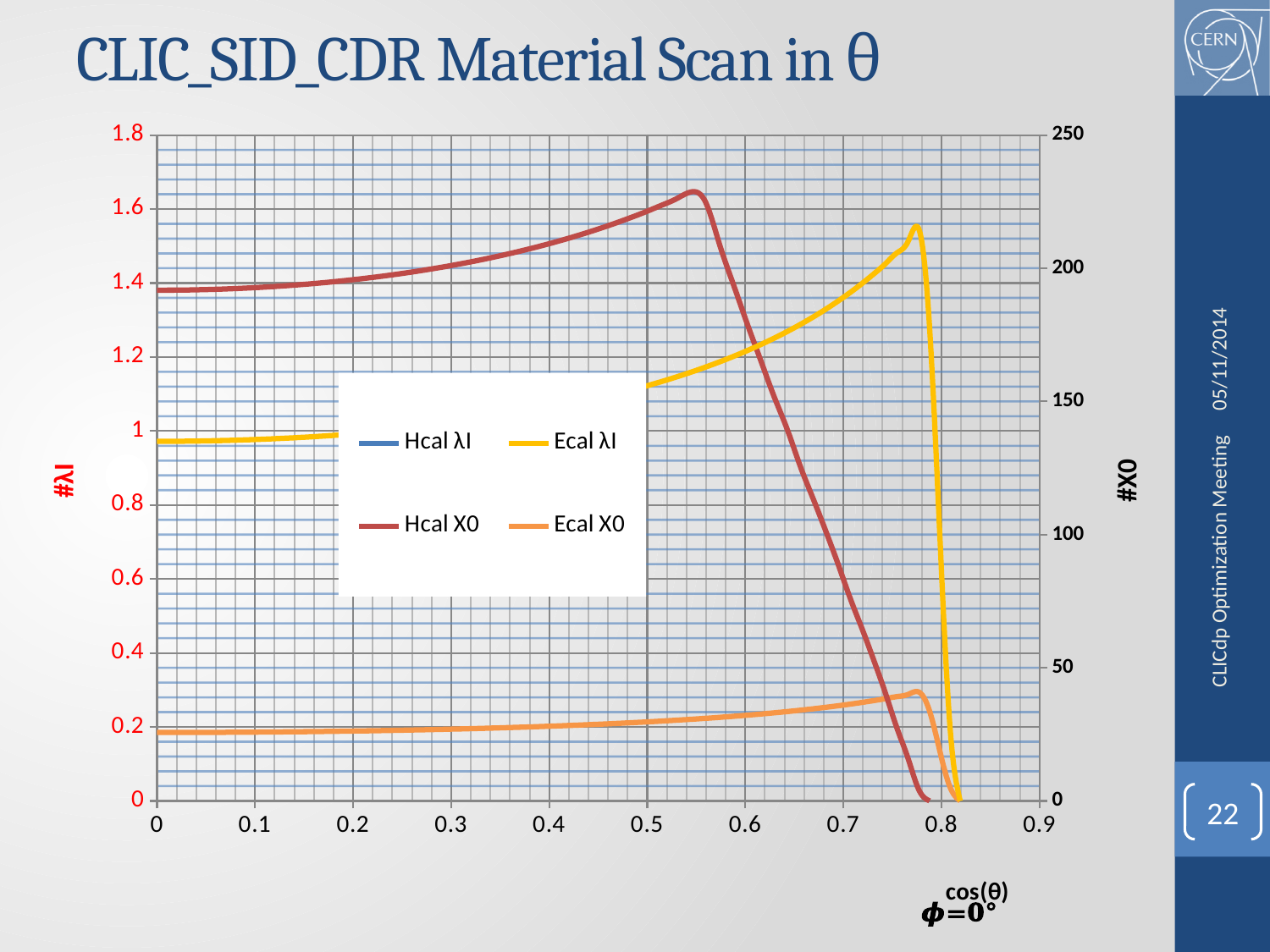
Between cos(θ)=0.6 and cos(θ)=0.8, does the Hcal X0 line rise or fall? fall At cos(θ)=0.3, which line is higher on the chart, Hcal X0 or Ecal X0? Hcal X0 What kind of chart is shown on the slide? line chart Does the peak of the Hcal X0 line lie above or below the 200 gridline of the right axis? above What is the label of the left vertical axis? #λI Does the peak of the Ecal λI line lie above or below the 1.4 gridline of the left axis? above What is the title of the chart on the slide? CLIC_SID_CDR Material Scan in θ How many labelled tick values are shown on the cos(θ) axis? 10 How many series does the chart legend list? 4 Between cos(θ)=0 and cos(θ)=0.5, does the Hcal X0 line rise or fall? rise Which series reaches the highest point on the chart? Hcal X0 At cos(θ)=0.7, which line is higher on the chart, Ecal λI or Hcal X0? Ecal λI